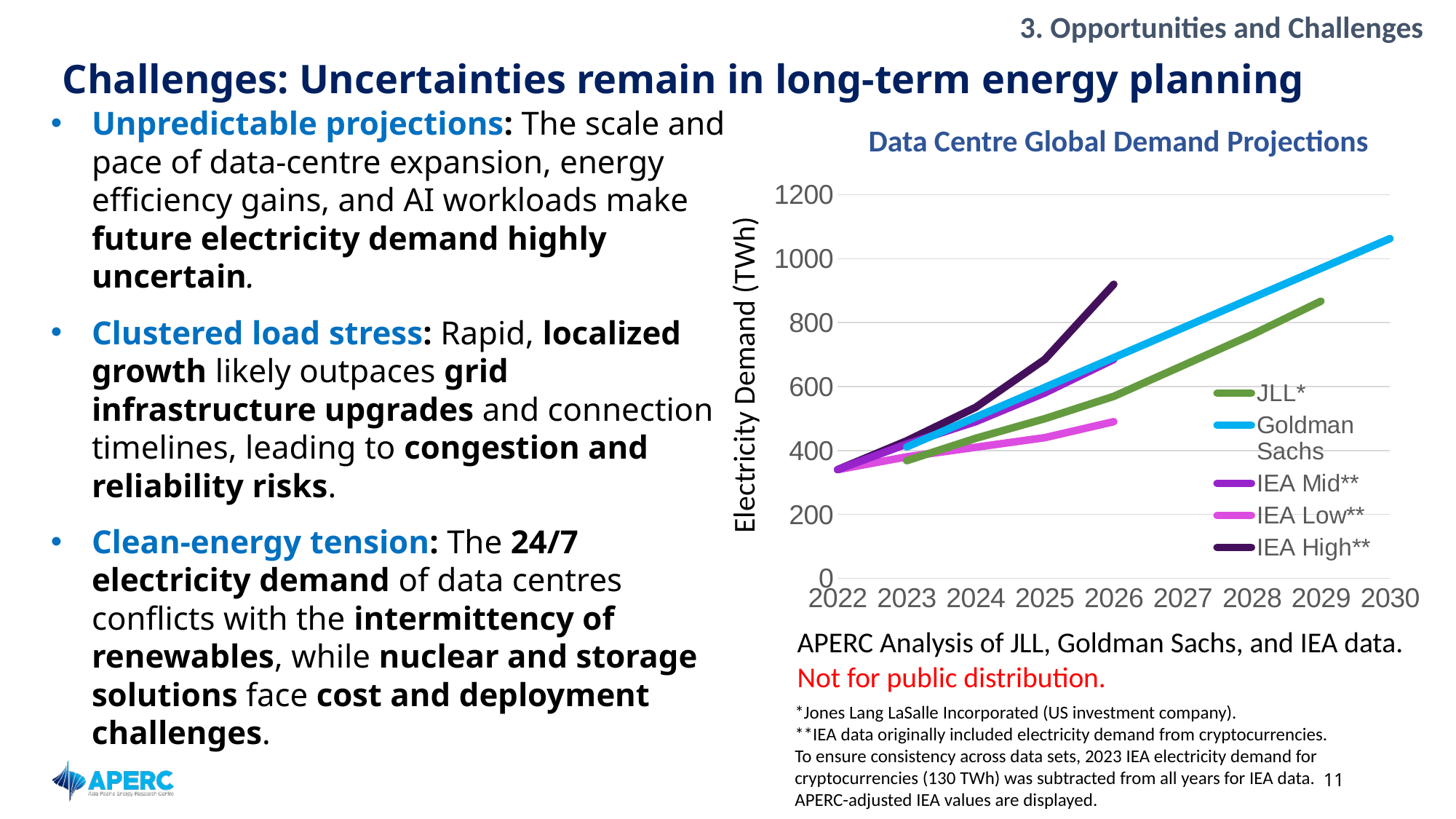
In 2026, which is larger: the JLL* value or the IEA Low** value? JLL* How many years are labelled on the x axis of the chart? 9 Is the Goldman Sachs value for 2030 greater or less than 1000? greater What is the title of the chart? Data Centre Global Demand Projections Is the JLL* value for 2029 greater or less than 800? greater How many series does the legend of the Data Centre Global Demand Projections chart list? 5 Is the IEA High** value for 2026 greater or less than 800? greater Do the projected values for Goldman Sachs rise or fall from 2022 to 2030? Rise What is the label of the y axis of the chart? Electricity Demand (TWh) What kind of chart is shown on the slide? Line chart Which series has the highest value in 2026? IEA High**